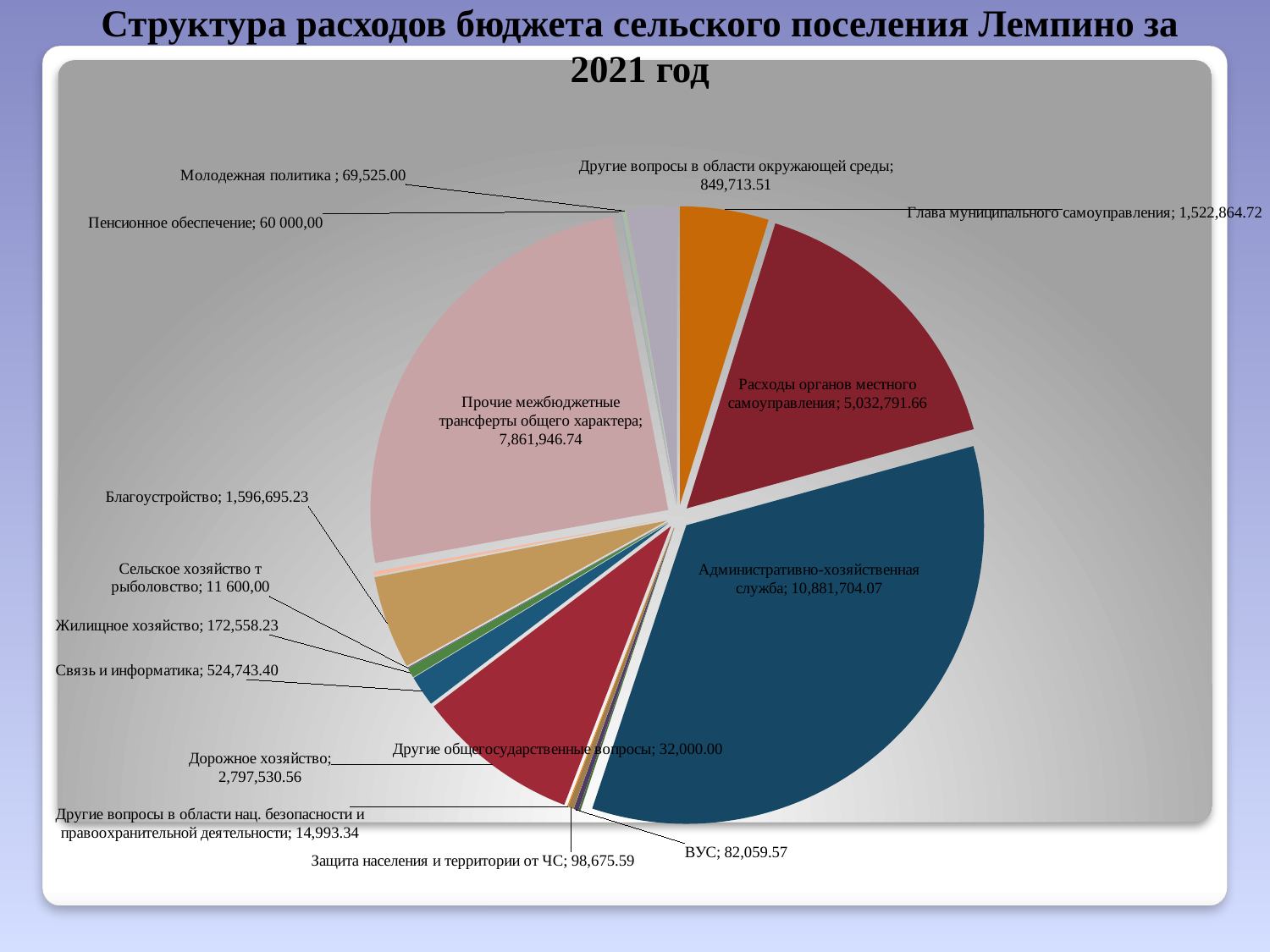
Which is larger: Дорожное хозяйство or Благоустройство? Дорожное хозяйство Which category has the largest slice of the pie? Административно-хозяйственная служба What is the value for ВУС? 82,059.57 What type of chart is shown on the slide? Pie chart What is the value for Административно-хозяйственная служба? 10,881,704.07 What is the value for Дорожное хозяйство? 2,797,530.56 What is the difference between Расходы органов местного самоуправления and Дорожное хозяйство? 2,235,261.10 What is the difference between Административно-хозяйственная служба and Прочие межбюджетные трансферты общего характера? 3,019,757.33 What is the value for Прочие межбюджетные трансферты общего характера? 7,861,946.74 What is the value for Связь и информатика? 524,743.40 Which category has the smallest value? Сельское хозяйство т рыболовство